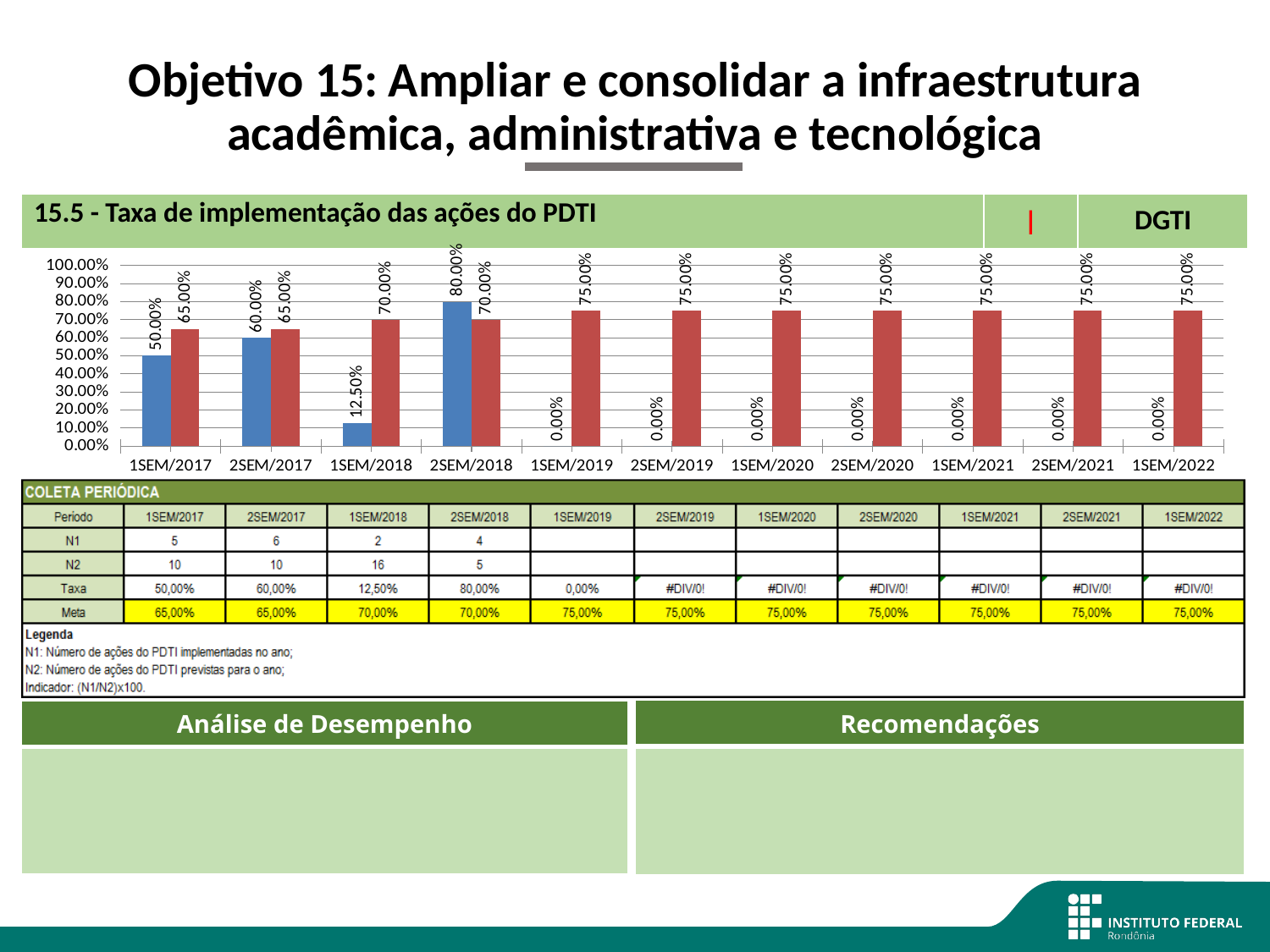
What is the value of the blue bar for 1SEM/2018? 12.50% What kind of chart is shown on the slide? Bar chart What is the value of the red bar for 2SEM/2018? 70.00% For 1SEM/2017, which is larger, the blue bar or the red bar? The red bar (65.00%) Which period has the highest blue bar? 2SEM/2018 What is the difference between the red bar and the blue bar for 1SEM/2018? 57.50% What is the value of the blue bar for 1SEM/2019? 0.00% What is the title of the chart? 15.5 - Taxa de implementação das ações do PDTI Is the value of the blue bar for 1SEM/2018 greater or less than 20.00%? less By how much does the blue bar exceed the red bar for 2SEM/2018? 10.00% How many periods are shown on the x axis of the chart? 11 Which period has the lowest red bar? 1SEM/2017 and 2SEM/2017 (both 65.00%)